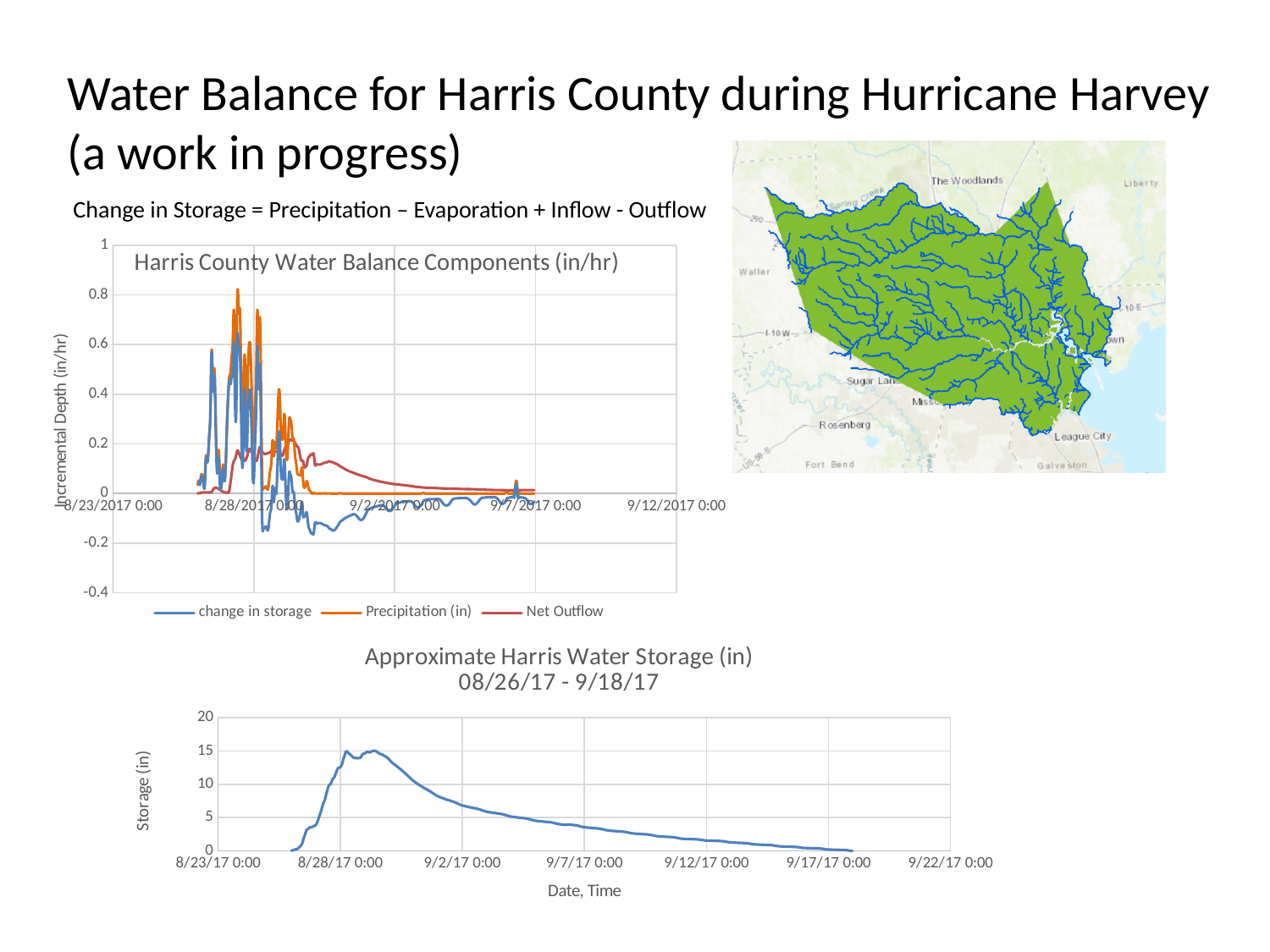
In the 'Harris County Water Balance Components (in/hr)' chart, what are the three series named in the legend? change in storage, Precipitation (in), Net Outflow In the 'Approximate Harris Water Storage (in)' chart, is the peak storage value greater or less than 10? greater In the 'Harris County Water Balance Components (in/hr)' chart, which series reaches the highest peak value? Precipitation (in) In the 'Approximate Harris Water Storage (in)' chart, is the peak storage value greater or less than 20? less In the 'Harris County Water Balance Components (in/hr)' chart, is the lowest value of change in storage greater or less than 0? less What is the x-axis label of the 'Approximate Harris Water Storage (in)' chart? Date, Time What kind of chart is the 'Harris County Water Balance Components (in/hr)' chart? line chart How many series does the legend of the 'Harris County Water Balance Components (in/hr)' chart list? 3 What kind of chart is the 'Approximate Harris Water Storage (in)' chart? line chart In the 'Approximate Harris Water Storage (in)' chart, do the values rise or fall between 9/2/17 and 9/17/17? fall